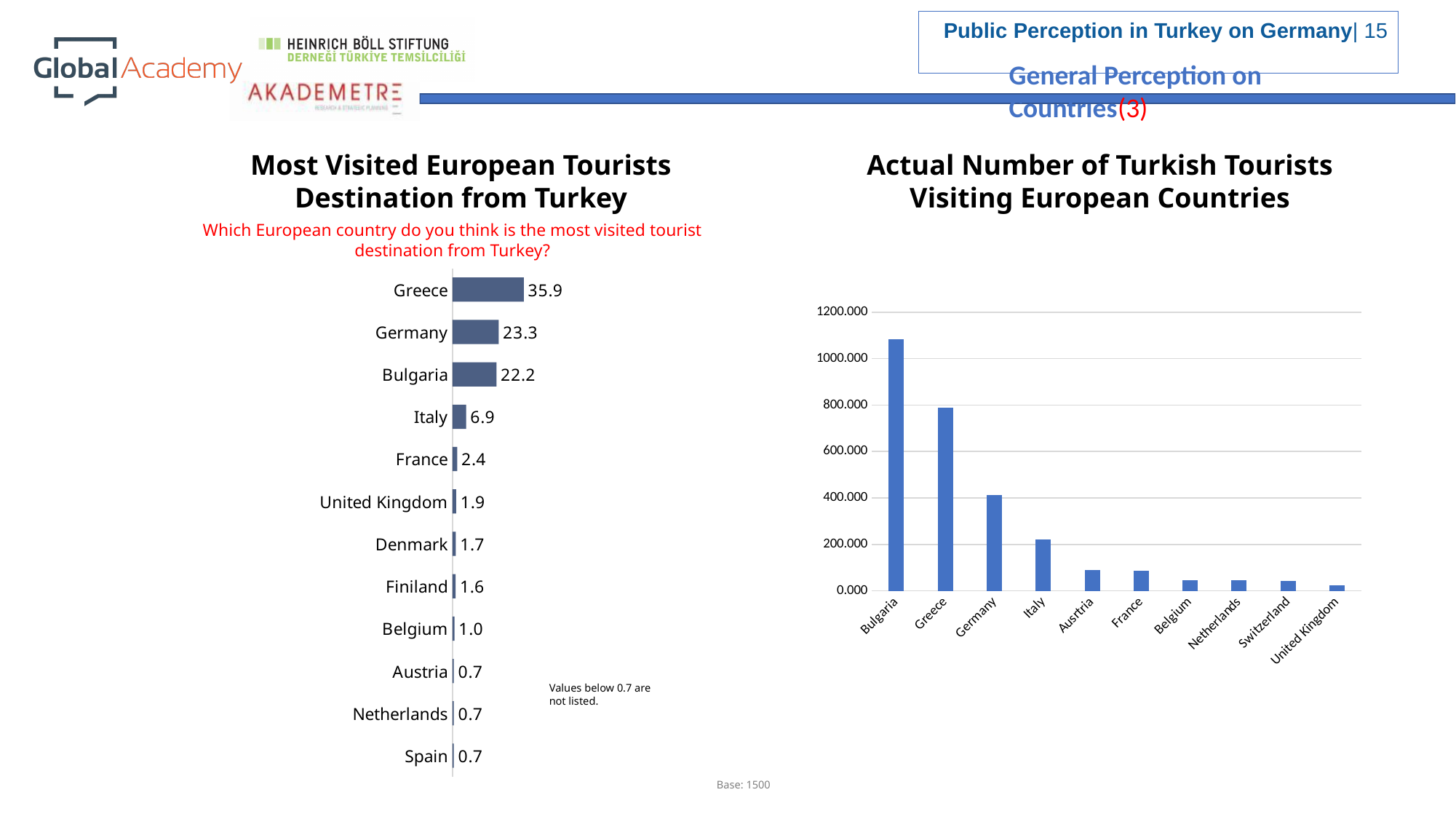
In the 'Most Visited European Tourists Destination from Turkey' chart, which country has the highest value? Greece In the 'Most Visited European Tourists Destination from Turkey' chart, which is larger, the value for Italy or the value for France? Italy In the 'Actual Number of Turkish Tourists Visiting European Countries' chart, which country has the highest value? Bulgaria In the 'Most Visited European Tourists Destination from Turkey' chart, what is the difference between the values for Germany and Bulgaria? 1.1 In the 'Most Visited European Tourists Destination from Turkey' chart, what is the value for Greece? 35.9 How many countries are shown in the 'Actual Number of Turkish Tourists Visiting European Countries' chart? 10 How many countries are listed in the 'Most Visited European Tourists Destination from Turkey' chart? 12 What kind of chart is the 'Most Visited European Tourists Destination from Turkey' chart? Bar chart In the 'Most Visited European Tourists Destination from Turkey' chart, what is the value for Bulgaria? 22.2 In the 'Actual Number of Turkish Tourists Visiting European Countries' chart, is the value for Bulgaria greater or less than 1000.000? greater In the 'Actual Number of Turkish Tourists Visiting European Countries' chart, is the value for Germany greater or less than 600.000? less In the 'Actual Number of Turkish Tourists Visiting European Countries' chart, which country has the lowest value? United Kingdom